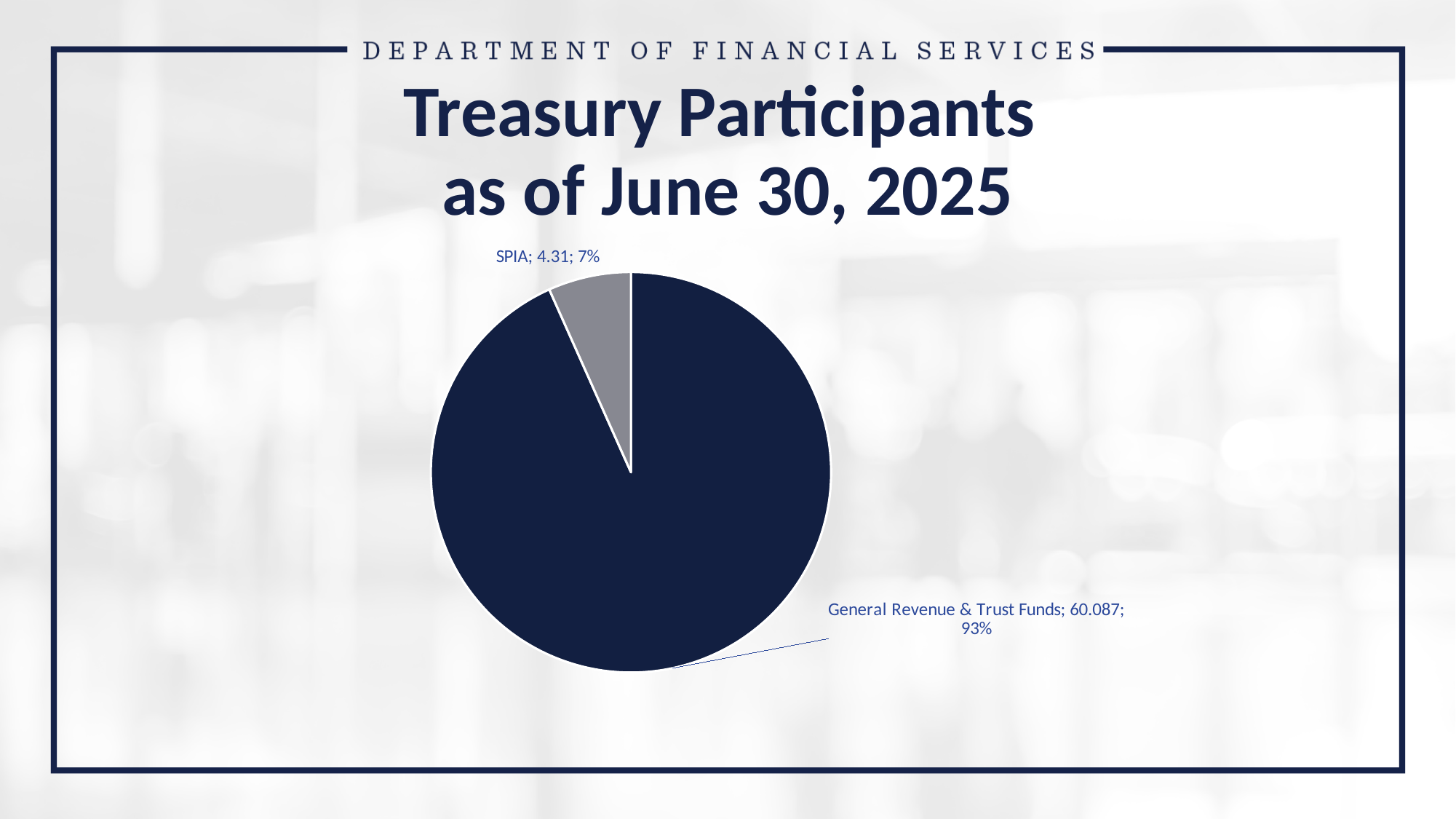
What is the title of the chart? Treasury Participants as of June 30, 2025 What is the value for SPIA? 4.31 What share of the pie does General Revenue & Trust Funds represent? 93% What is the value for General Revenue & Trust Funds? 60.087 What colour is the SPIA slice? Gray What kind of chart is shown on the slide? Pie chart How many slices does the pie chart have? 2 Which is larger, SPIA or General Revenue & Trust Funds? General Revenue & Trust Funds Which slice is the smallest? SPIA What is the difference between the values for General Revenue & Trust Funds and SPIA? 55.777 Which slice is the largest? General Revenue & Trust Funds What share of the pie does SPIA represent? 7%